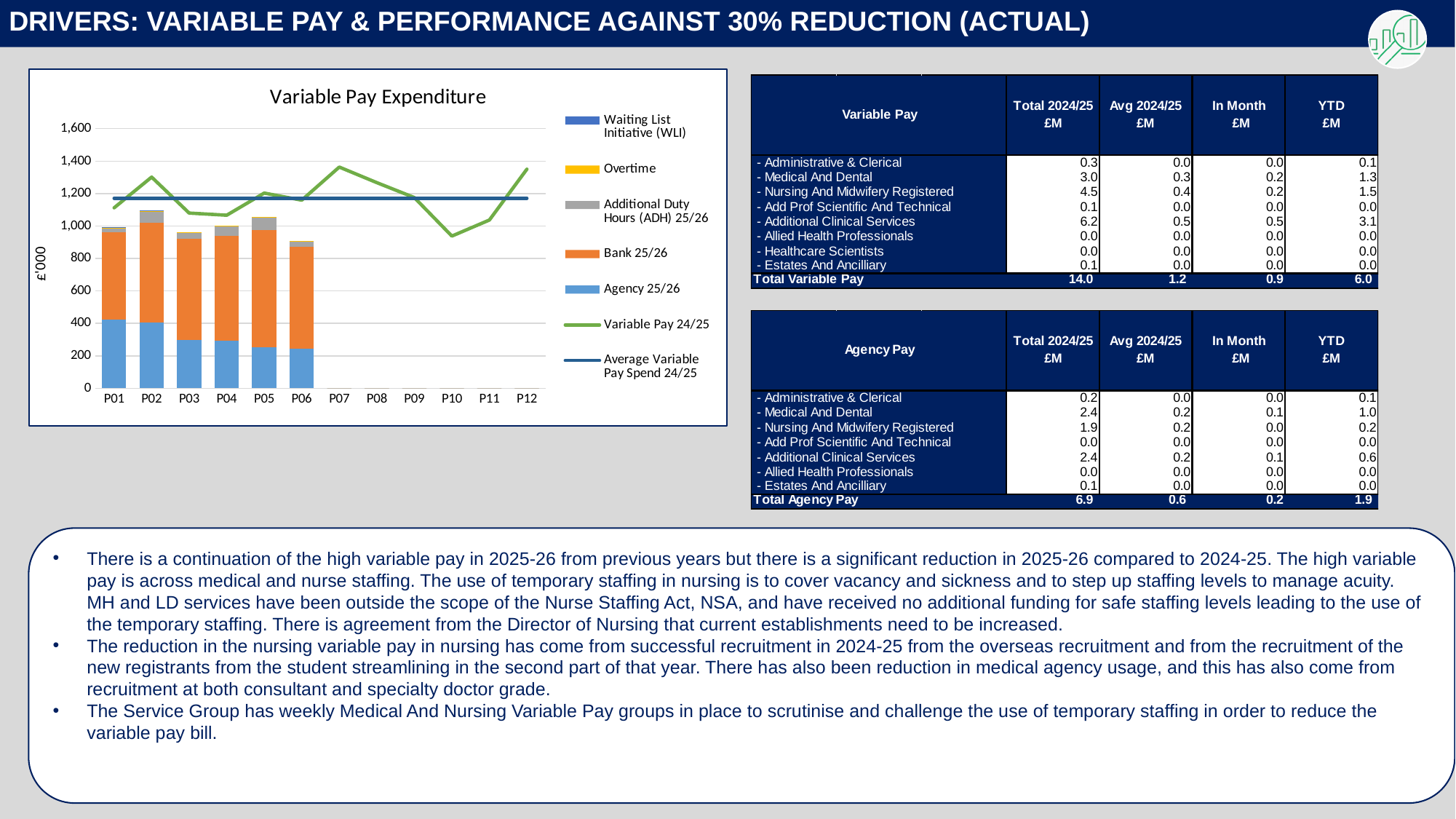
In the Variable Pay Expenditure chart, is the Variable Pay 24/25 value at P10 greater or less than 1,000? less In the Variable Pay Expenditure chart, is the Average Variable Pay Spend 24/25 line greater or less than 1,000? greater What type of chart is the Variable Pay Expenditure chart? Bar chart with line series (stacked bars and lines) How many periods are shown on the x axis of the Variable Pay Expenditure chart? 12 What is the y-axis label of the Variable Pay Expenditure chart? £'000 In the Variable Pay Expenditure chart, is the Agency 25/26 value at P06 greater or less than 200? greater In the Variable Pay Expenditure chart, which period has the lowest Variable Pay 24/25 value? P10 What is the title of the chart on the slide? Variable Pay Expenditure How many series does the legend of the Variable Pay Expenditure chart list? 7 In the Variable Pay Expenditure chart, which of the periods with stacked bars has the lowest total bar height? P06 In the Variable Pay Expenditure chart, does the Agency 25/26 series rise or fall from P01 to P06? fall